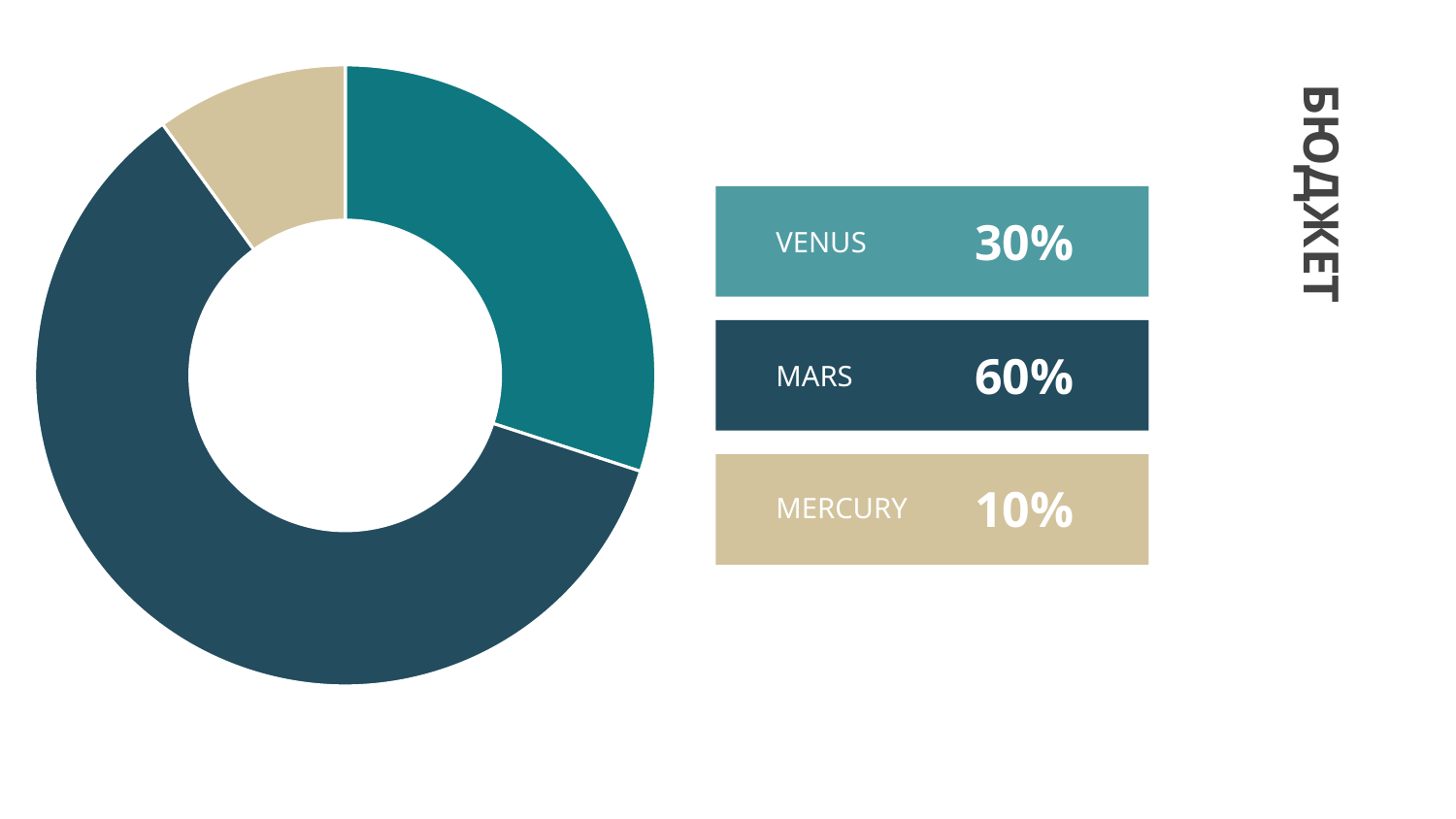
Which is larger, the share for Venus or the share for Mercury? Venus What kind of chart is shown on the slide? Pie chart (doughnut) How many categories are shown in the chart? 3 What is the difference in percentage points between Mars and Venus? 30% What share of the budget does Mars have? 60% Which category has the smallest share of the chart? Mercury Which category is shown in the beige colour? Mercury What share of the budget does Venus have? 30% What is the difference in percentage points between Venus and Mercury? 20% Which category has the largest share of the chart? Mars What is the title shown on the slide? БЮДЖЕТ What share of the budget does Mercury have? 10%